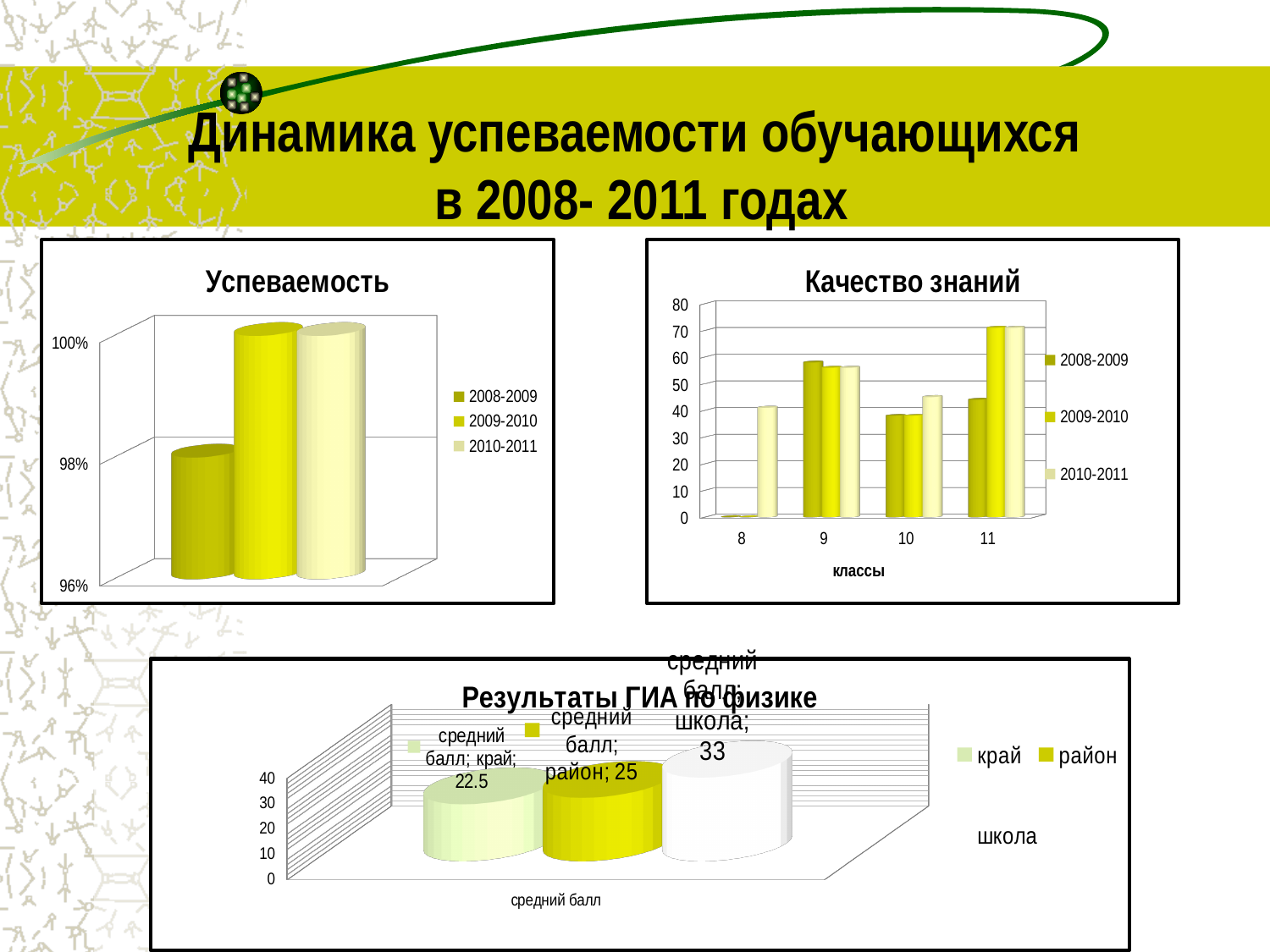
In the 'Качество знаний' chart, which is larger for the 2008-2009 series: class 9 or class 10? class 9 How many series does the legend of the 'Успеваемость' chart list? 3 In the 'Результаты ГИА по физике' chart, what is the average score (средний балл) for край? 22.5 In the 'Качество знаний' chart, is the 2010-2011 value for class 8 greater or less than 30? greater In the 'Качество знаний' chart, which class has the highest value for the 2010-2011 series? 11 How many classes (categories) are shown on the x axis of the 'Качество знаний' chart? 4 In the 'Качество знаний' chart, is the 2009-2010 value for class 11 greater or less than 60? greater In the 'Успеваемость' chart, is the value for 2008-2009 greater or less than 100%? less What kind of chart is the 'Качество знаний' chart? bar chart How many series does the legend of the 'Качество знаний' chart list? 3 In the 'Результаты ГИА по физике' chart, what is the difference between the школа value and the край value? 10.5 In the 'Результаты ГИА по физике' chart, what is the average score (средний балл) for школа? 33